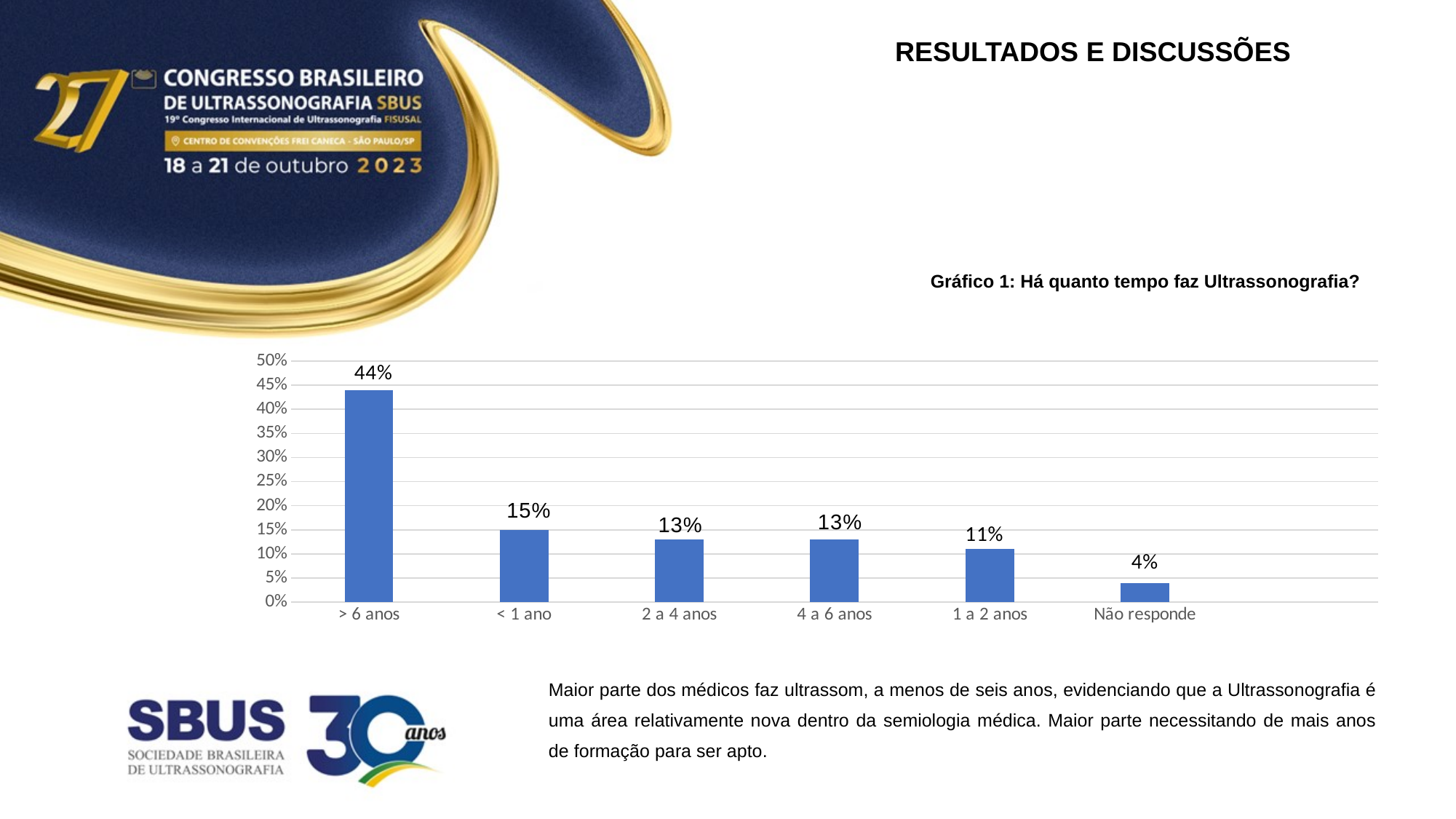
What is the value for "Não responde"? 4% What is the value for "> 6 anos"? 44% What is the value for "1 a 2 anos"? 11% How many categories are shown on the x axis? 6 Which is larger, the value for "< 1 ano" or the value for "1 a 2 anos"? < 1 ano What is the value for "< 1 ano"? 15% Which category has the highest value? > 6 anos Is the value for "> 6 anos" greater or less than 40%? greater What is the title of the chart? Gráfico 1: Há quanto tempo faz Ultrassonografia? What kind of chart is shown on the slide? bar chart What is the difference between the values for "> 6 anos" and "< 1 ano"? 29% Which category has the lowest value? Não responde